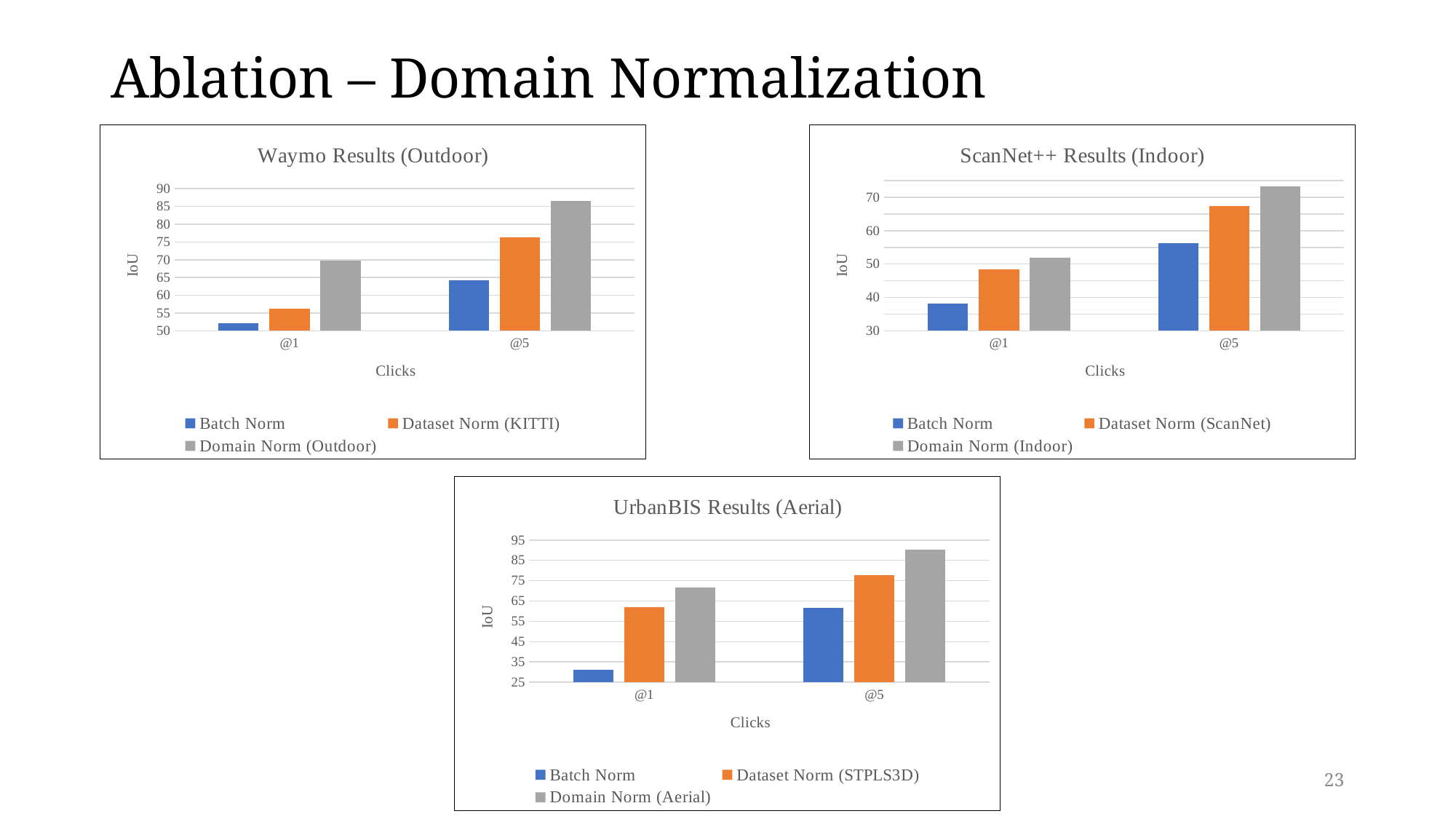
How many series does the legend of the ScanNet++ Results (Indoor) chart list? 3 In the Waymo Results (Outdoor) chart, which series has the highest IoU at @5 clicks? Domain Norm (Outdoor) In the Waymo Results (Outdoor) chart, is the Domain Norm (Outdoor) value at @1 greater or less than 75? less In the UrbanBIS Results (Aerial) chart, does the Batch Norm IoU rise or fall from @1 to @5 clicks? rise In the ScanNet++ Results (Indoor) chart, is the Domain Norm (Indoor) value at @5 greater or less than 70? greater How many click categories are shown on the x axis of the Waymo Results (Outdoor) chart? 2 In the ScanNet++ Results (Indoor) chart, is the Batch Norm value at @1 greater or less than 40? less What kind of chart is the UrbanBIS Results (Aerial) chart? bar chart In the UrbanBIS Results (Aerial) chart, which is larger at @1 clicks: Batch Norm or Dataset Norm (STPLS3D)? Dataset Norm (STPLS3D) In the ScanNet++ Results (Indoor) chart, which series has the lowest IoU at @1 clicks? Batch Norm